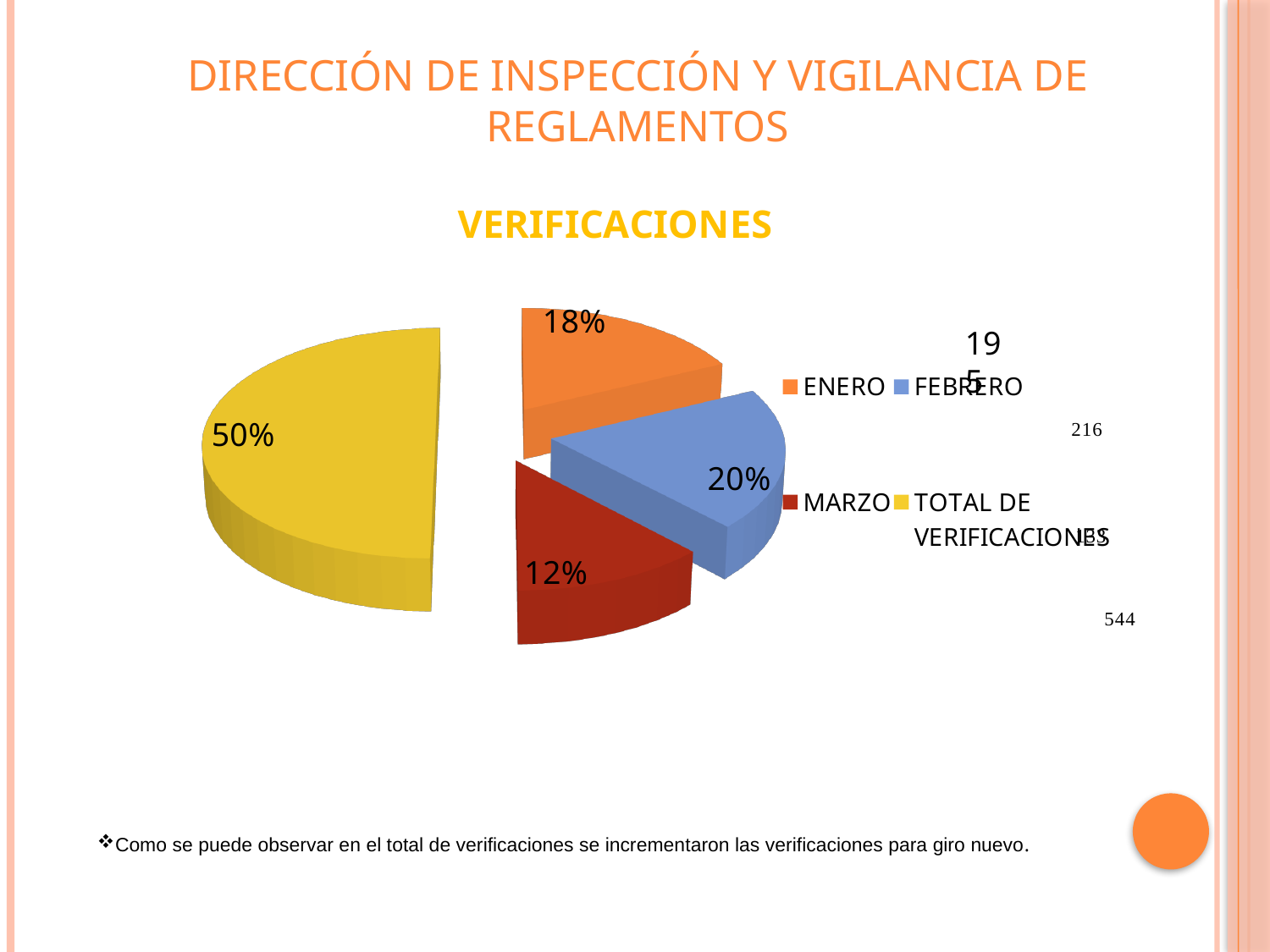
What percentage of the pie does TOTAL DE VERIFICACIONES represent? 50% How many entries does the legend list? 4 What is the title of the chart? VERIFICACIONES Which slice of the pie is the smallest? MARZO Which is larger, the ENERO slice or the FEBRERO slice? FEBRERO What colour is the MARZO slice? red What percentage of the pie does ENERO represent? 18% Which slice of the pie is the largest? TOTAL DE VERIFICACIONES What percentage of the pie does MARZO represent? 12% What type of chart is shown on the slide? pie chart What is the difference in percentage points between the FEBRERO slice and the MARZO slice? 8